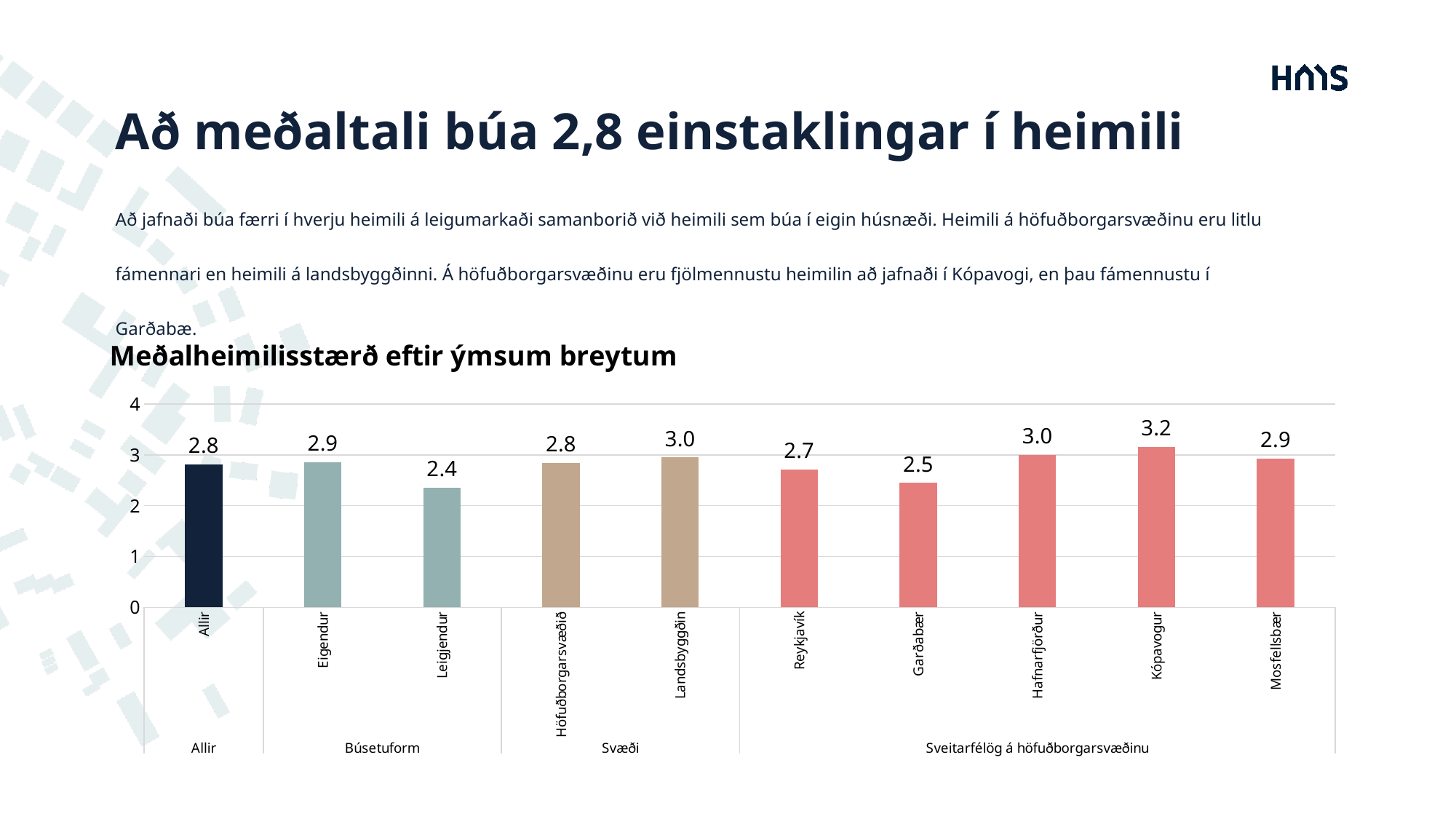
What is the difference between the values for Eigendur and Leigjendur? 0.5 What is the average household size for Leigjendur? 2.4 Which group label on the x axis contains the bars for Reykjavík, Garðabær, Hafnarfjörður, Kópavogur and Mosfellsbær? Sveitarfélög á höfuðborgarsvæðinu How many bars are plotted in the chart? 10 Which category has the lowest value in the chart? Leigjendur What is the difference between the values for Kópavogur and Garðabær? 0.7 What is the value shown for Landsbyggðin? 3.0 What is the title of the chart? Meðalheimilisstærð eftir ýmsum breytum What is the value shown for Kópavogur? 3.2 Which is larger, the value for Reykjavík or the value for Hafnarfjörður? Hafnarfjörður Which category has the highest value in the chart? Kópavogur What kind of chart is shown on the slide? Bar chart